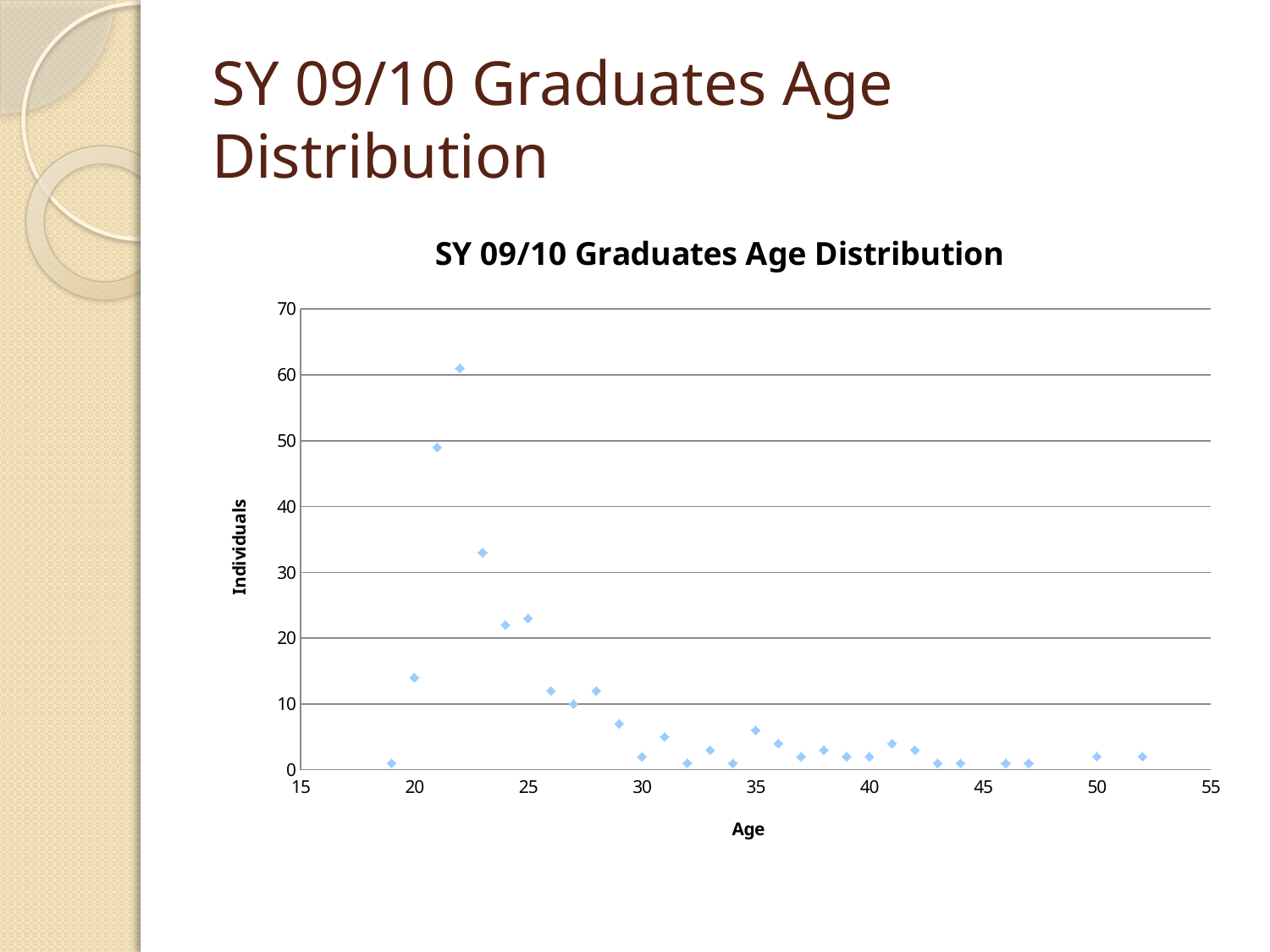
Which has more individuals, age 22 or age 21? age 22 At which age is the number of individuals highest? 22 Is the value for age 20 greater or less than 20? less Is the value for age 21 greater or less than 40? greater Do the values generally rise or fall as age increases beyond 22? fall What is the title of the chart? SY 09/10 Graduates Age Distribution What kind of chart is shown on the slide? scatter chart Is the value for age 23 greater or less than 30? greater What is the label on the vertical axis of the chart? Individuals Which has more individuals, age 21 or age 23? age 21